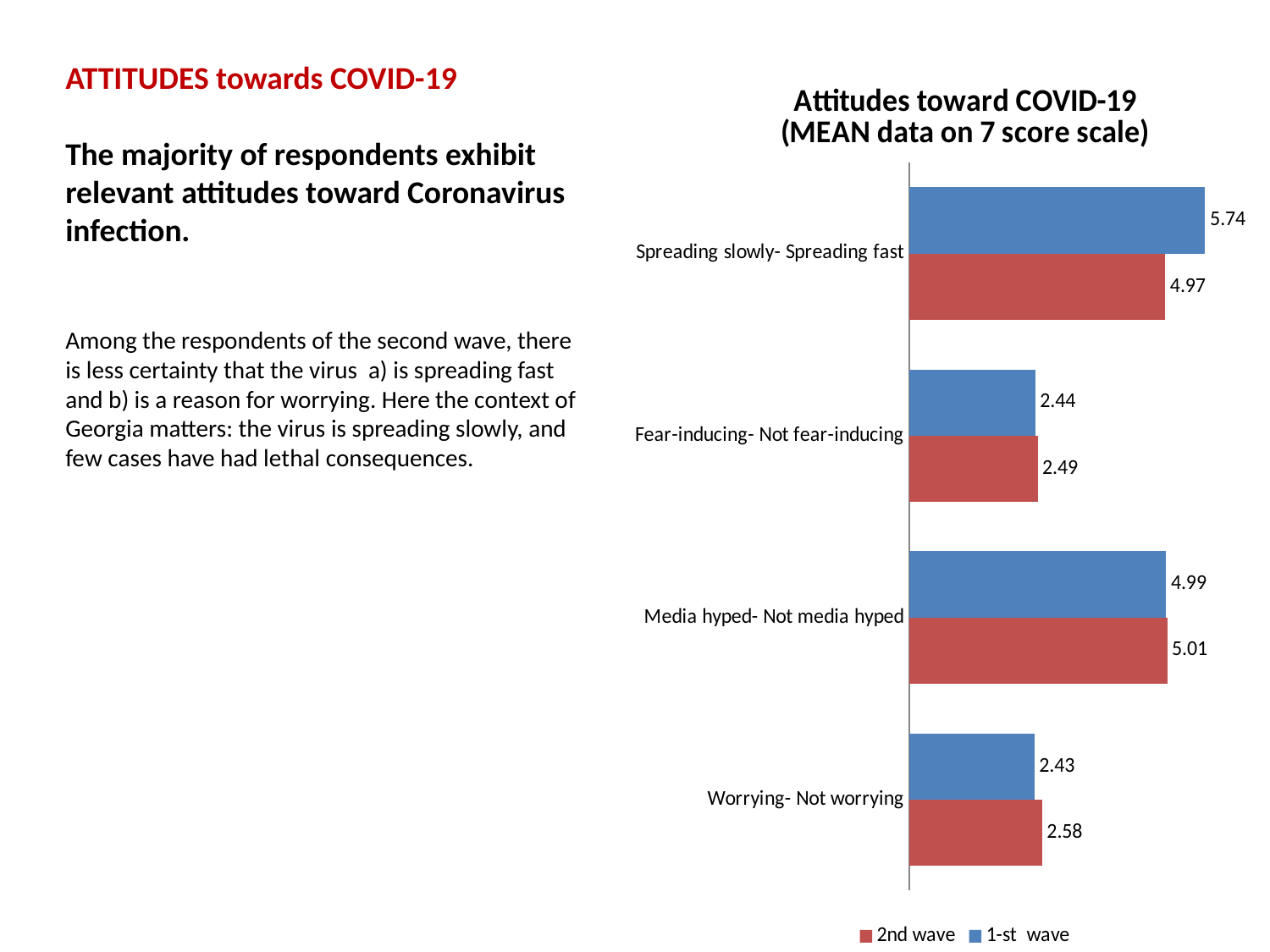
What is the 2nd wave value for "Media hyped- Not media hyped"? 5.01 Which category has the lowest 1-st wave value? Worrying- Not worrying How many series does the legend list? 2 What is the 1-st wave value for "Spreading slowly- Spreading fast"? 5.74 How many categories are shown on the chart? 4 What is the 1-st wave value for "Fear-inducing- Not fear-inducing"? 2.44 For "Spreading slowly- Spreading fast", which is larger: the 1-st wave value or the 2nd wave value? 1-st wave Which category has the highest 1-st wave value? Spreading slowly- Spreading fast What is the difference between the 2nd wave and 1-st wave values for "Worrying- Not worrying"? 0.15 What is the difference between the 1-st wave and 2nd wave values for "Spreading slowly- Spreading fast"? 0.77 What kind of chart is shown on the slide? Bar chart What is the 2nd wave value for "Worrying- Not worrying"? 2.58